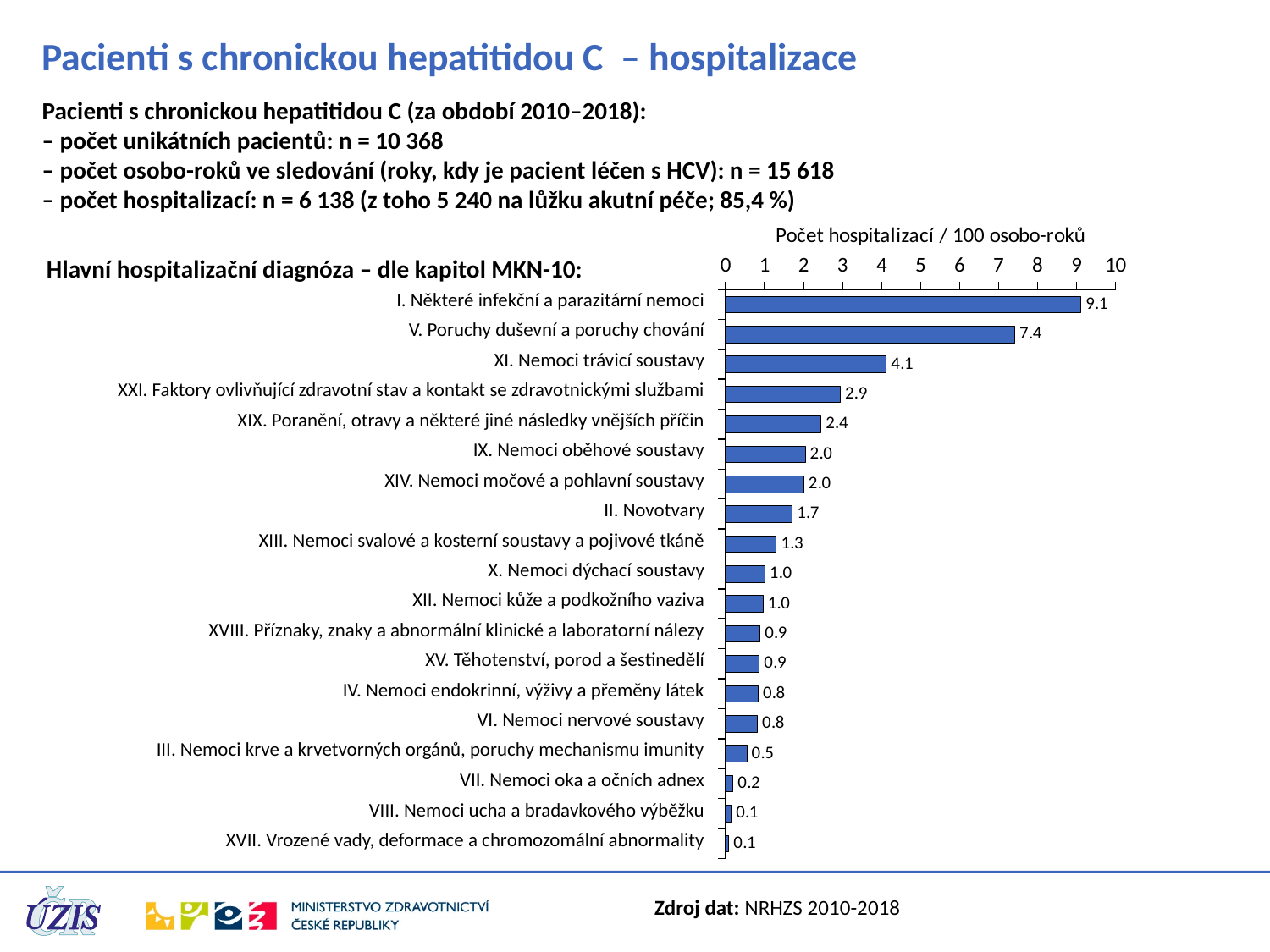
What kind of chart is shown on the slide? bar chart How many diagnosis chapters (categories) are plotted in the chart? 19 What is the difference between the values for 'I. Některé infekční a parazitární nemoci' and 'V. Poruchy duševní a poruchy chování'? 1.7 What value is shown for 'XI. Nemoci trávicí soustavy'? 4.1 Which diagnosis chapter has the highest number of hospitalizations per 100 person-years? I. Některé infekční a parazitární nemoci What is the number of hospitalizations per 100 person-years for 'I. Některé infekční a parazitární nemoci'? 9.1 What is the title of the chart's value axis? Počet hospitalizací / 100 osobo-roků What value is shown for 'II. Novotvary'? 1.7 Which has a larger value: 'XXI. Faktory ovlivňující zdravotní stav a kontakt se zdravotnickými službami' or 'XIX. Poranění, otravy a některé jiné následky vnějších příčin'? XXI. Faktory ovlivňující zdravotní stav a kontakt se zdravotnickými službami What is the value shown for 'XIII. Nemoci svalové a kosterní soustavy a pojivové tkáně'? 1.3 Is the value for 'V. Poruchy duševní a poruchy chování' greater or less than 7? greater What is the difference between the values for 'XI. Nemoci trávicí soustavy' and 'IX. Nemoci oběhové soustavy'? 2.1